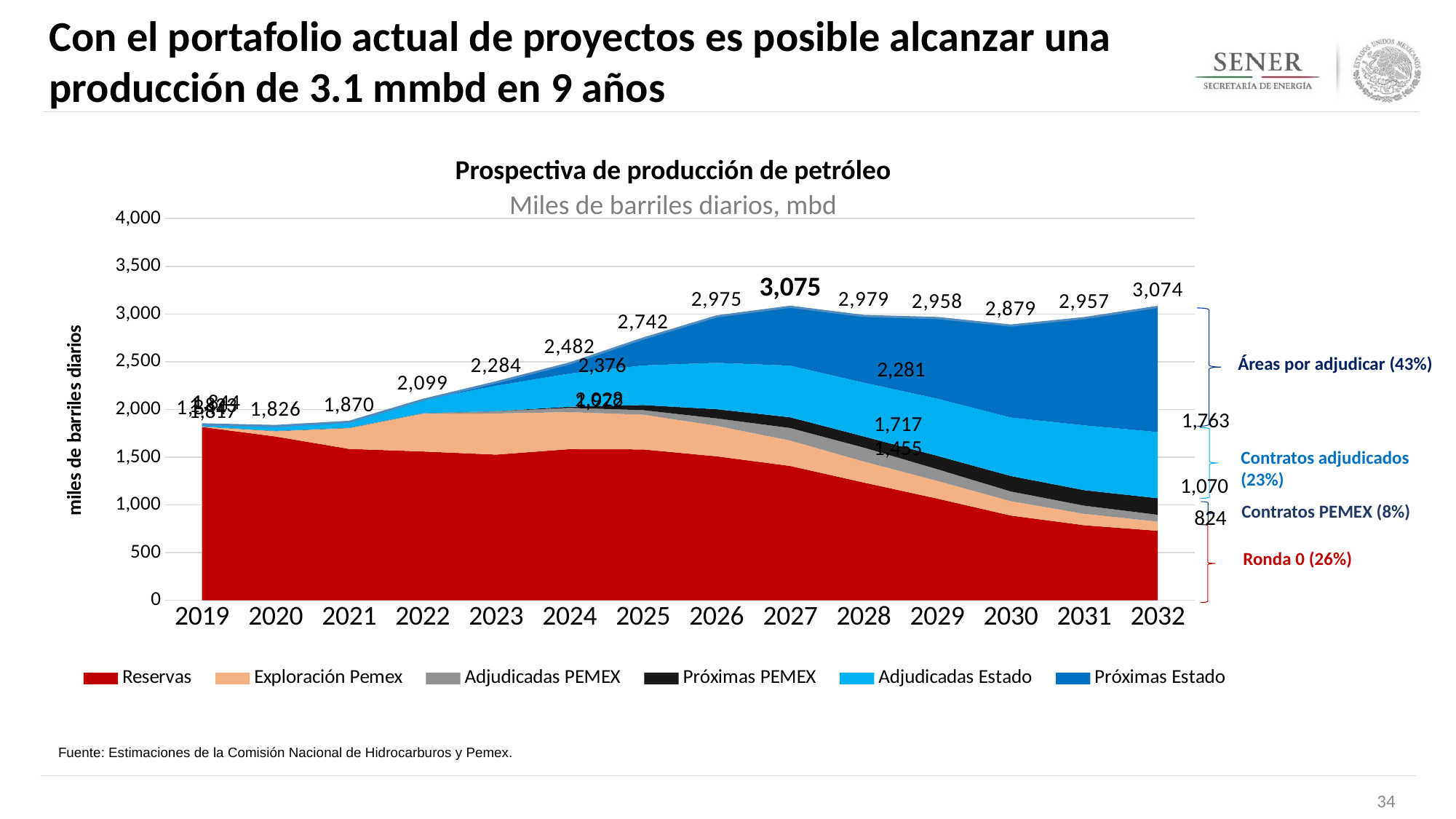
What type of chart is shown on the slide? Area chart What is the title of the chart? Prospectiva de producción de petróleo What is the difference between the total values labelled for 2027 and 2026? 100 What is the total production value labelled for 2030? 2,879 Which year has the larger total value, 2023 or 2022? 2023 Is the total value for 2030 greater or less than 2,500? greater How many years are shown on the x axis? 14 What is the total production value labelled for 2022? 2,099 What is the difference between the total values labelled for 2025 and 2024? 260 What is the total production value labelled for 2027? 3,075 Does the total production rise or fall from 2020 to 2027? Rises How many series does the legend list? 6